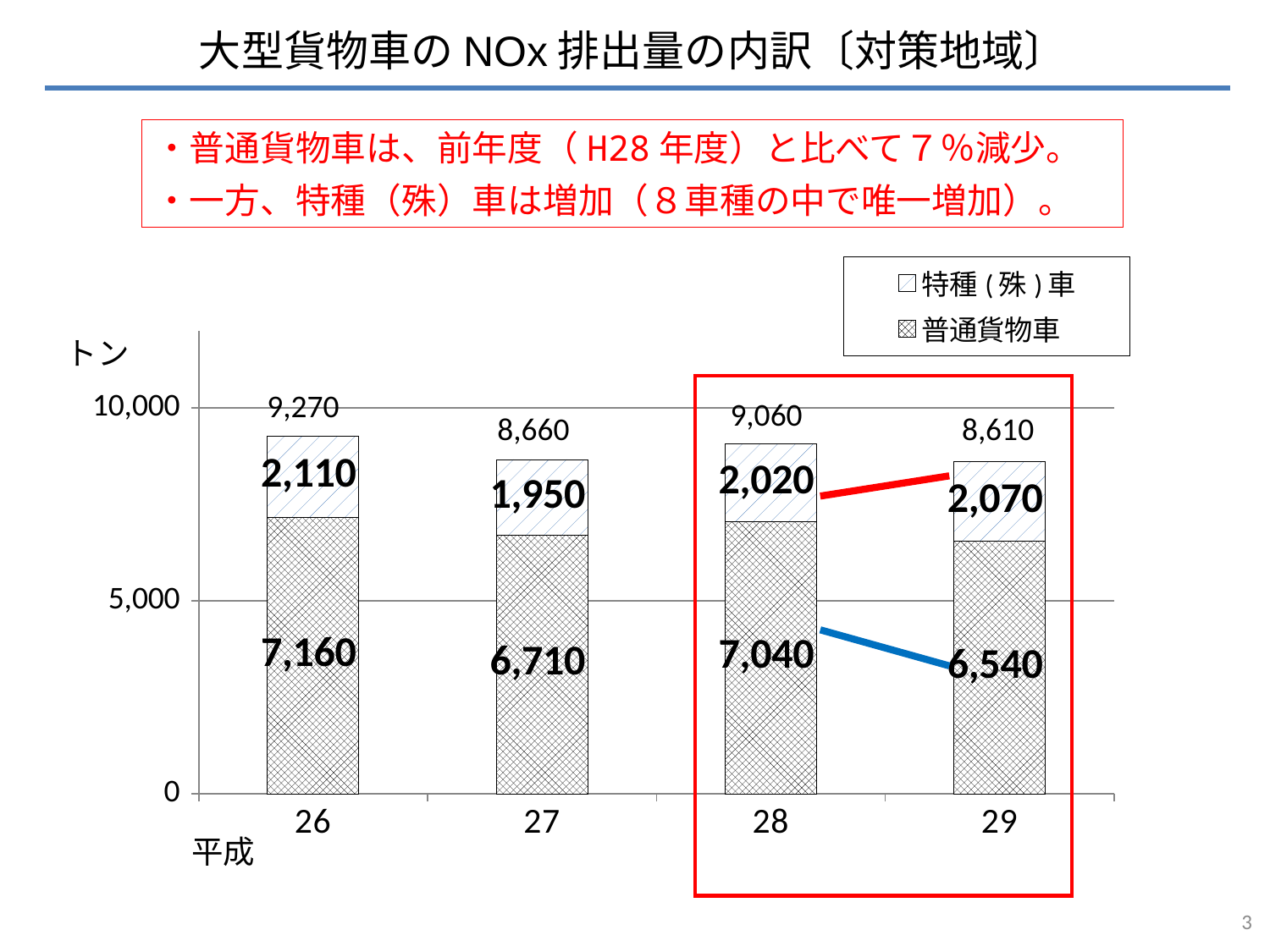
What kind of chart is shown? stacked bar chart What unit is shown on the y axis? トン How many series does the legend list? 2 What is the difference between the 普通貨物車 values for 平成28 and 平成29? 500 Is the total for 平成27 greater or less than 10,000? less What is the value for 普通貨物車 in 平成29? 6,540 Which year has the highest total NOx emissions? 平成26 What is the value for 特種(殊)車 in 平成26? 2,110 What is the total of the stacked bar for 平成28? 9,060 Which is larger, the 特種(殊)車 value for 平成28 or for 平成29? 平成29 Which year has the lowest value for 普通貨物車? 平成29 How many years are shown on the x axis? 4